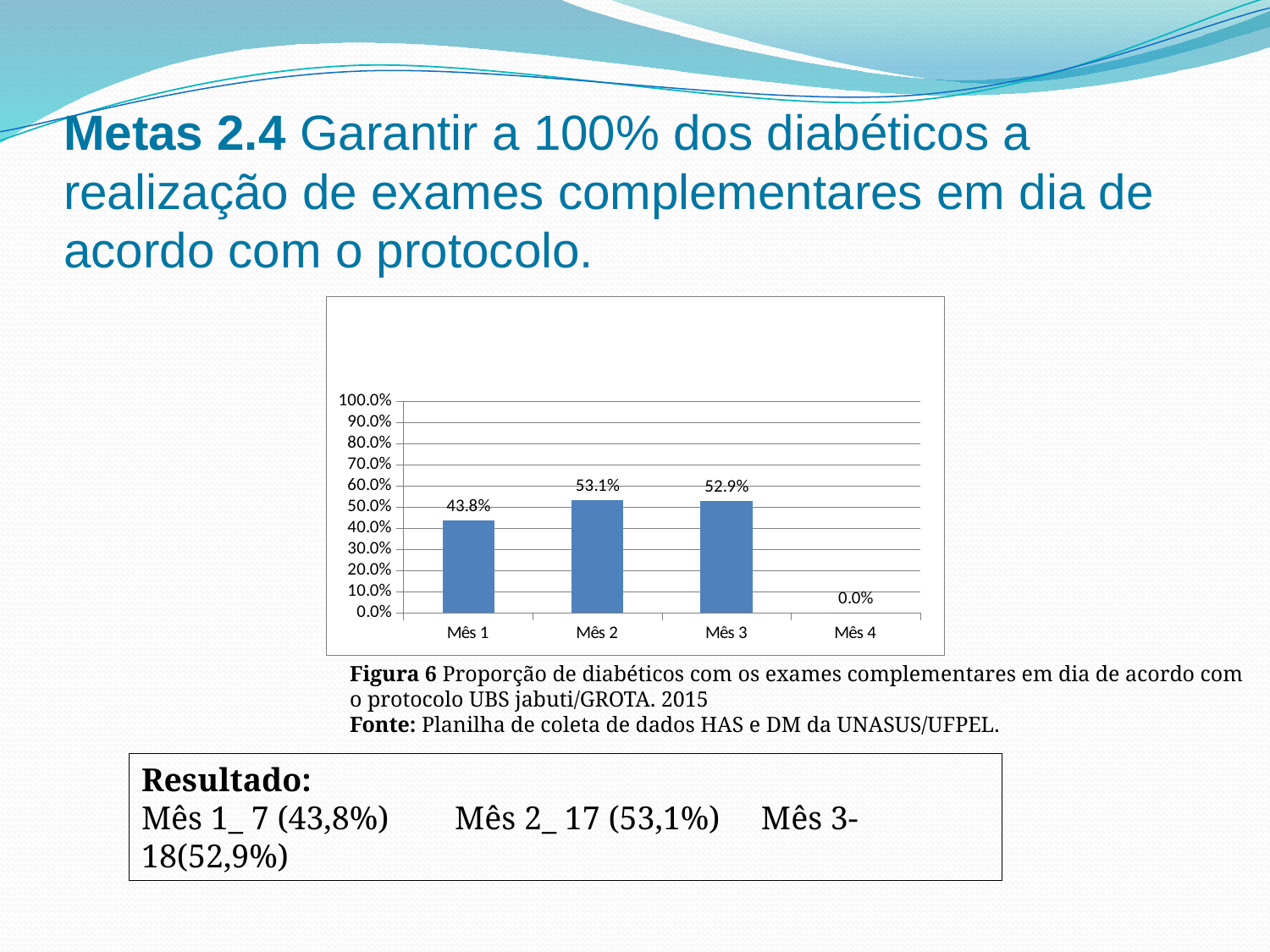
Which month has the lowest value? Mês 4 Which is larger, the value for Mês 1 or the value for Mês 3? Mês 3 What is the difference between the values for Mês 2 and Mês 1? 9.3% Does the value rise or fall from Mês 1 to Mês 2? rise What is the value for Mês 1? 43.8% What is the value for Mês 3? 52.9% What is the value for Mês 2? 53.1% Is the value for Mês 1 greater or less than 50.0%? less Which month has the highest value? Mês 2 What kind of chart is shown on the slide? bar chart What is the value for Mês 4? 0.0% How many months are shown on the x axis? 4